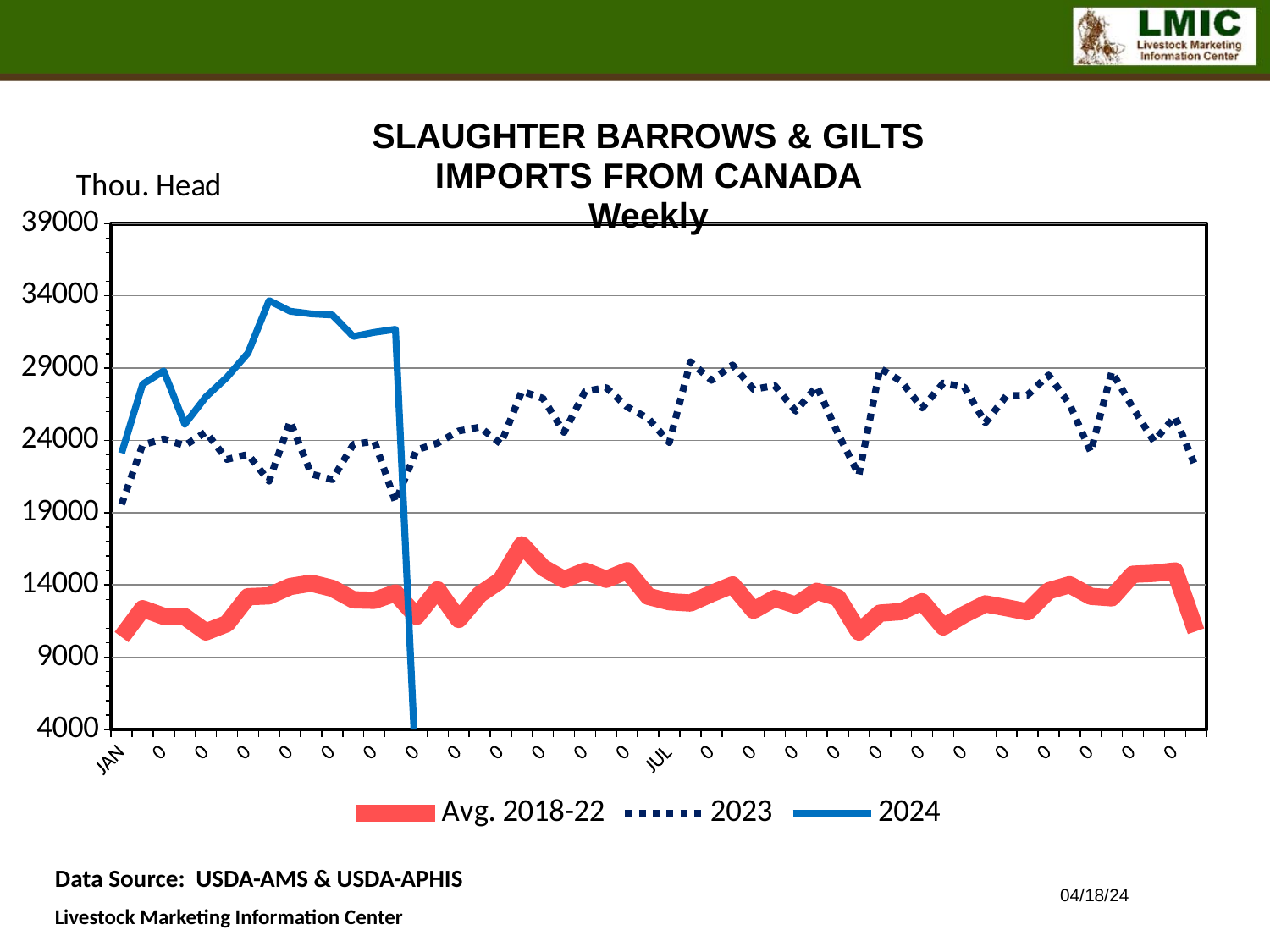
Across the year, which series is generally higher, Avg. 2018-22 or 2023? 2023 What unit label is shown above the vertical axis? Thou. Head Is the highest value of the Avg. 2018-22 series greater or less than 19000? less Is the value for Avg. 2018-22 at JAN greater or less than 14000? less What is the title of the chart? SLAUGHTER BARROWS & GILTS IMPORTS FROM CANADA Weekly Is the lowest value of the 2023 series greater or less than 14000? greater How many series does the legend list? 3 What kind of chart is shown on the slide? line chart Does the 2024 series generally rise or fall from JAN to its peak in the first weeks of the year? rise At JAN, which series has the higher value, 2024 or 2023? 2024